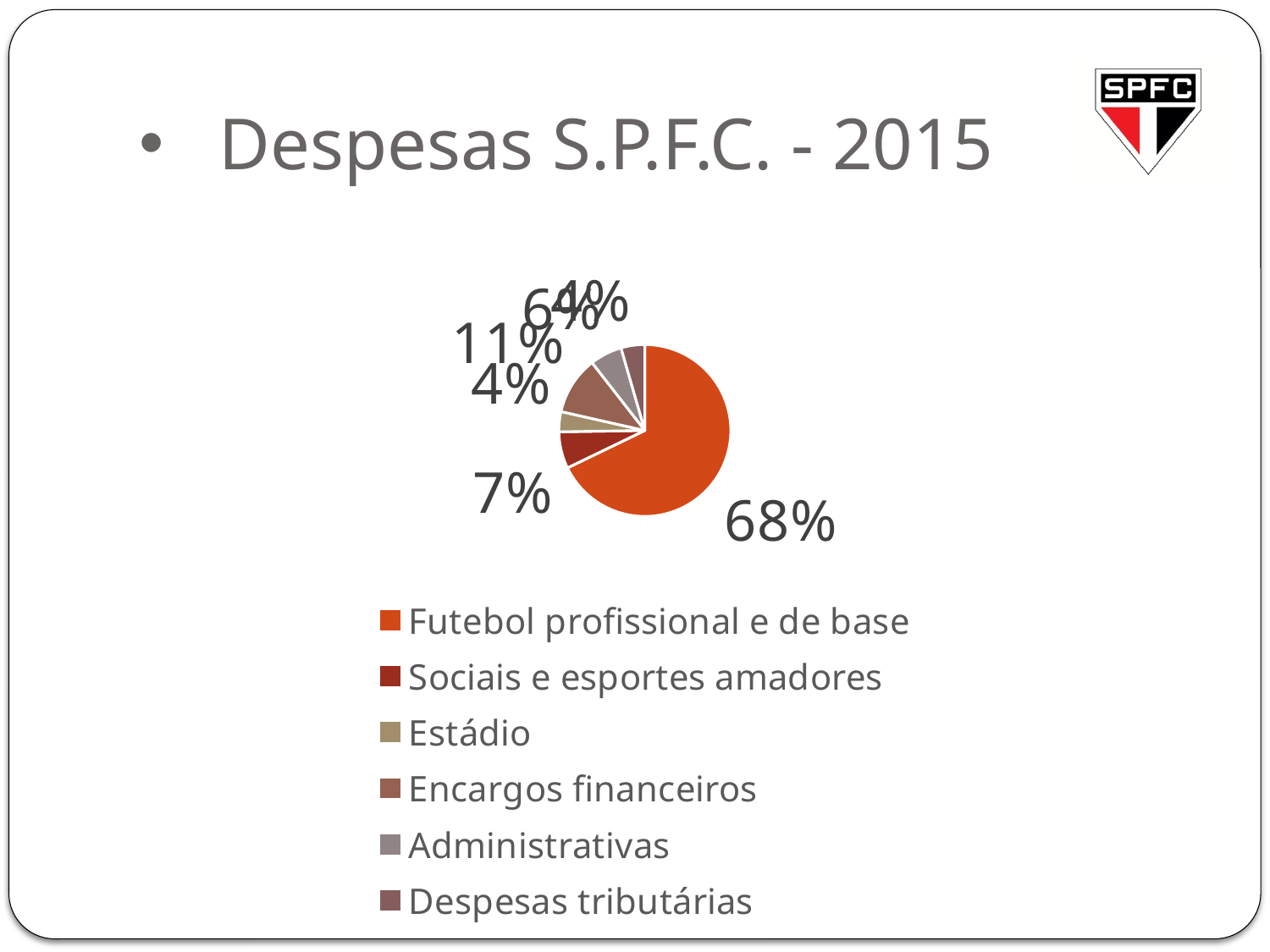
Which category has the largest slice of the pie? Futebol profissional e de base By how many percentage points does Sociais e esportes amadores exceed Estádio? 3 percentage points What percentage is shown for Sociais e esportes amadores? 7% What percentage is shown for Estádio? 4% How many categories does the legend list? 6 By how many percentage points does Futebol profissional e de base exceed Encargos financeiros? 57 percentage points What share of expenses does the slice for Futebol profissional e de base represent? 68% What is the title of the slide containing the chart? Despesas S.P.F.C. - 2015 What percentage is shown for Encargos financeiros? 11% Which is larger, the slice for Encargos financeiros or the slice for Sociais e esportes amadores? Encargos financeiros Which is larger, the slice for Futebol profissional e de base or the slice for Estádio? Futebol profissional e de base What kind of chart is shown on the slide? Pie chart